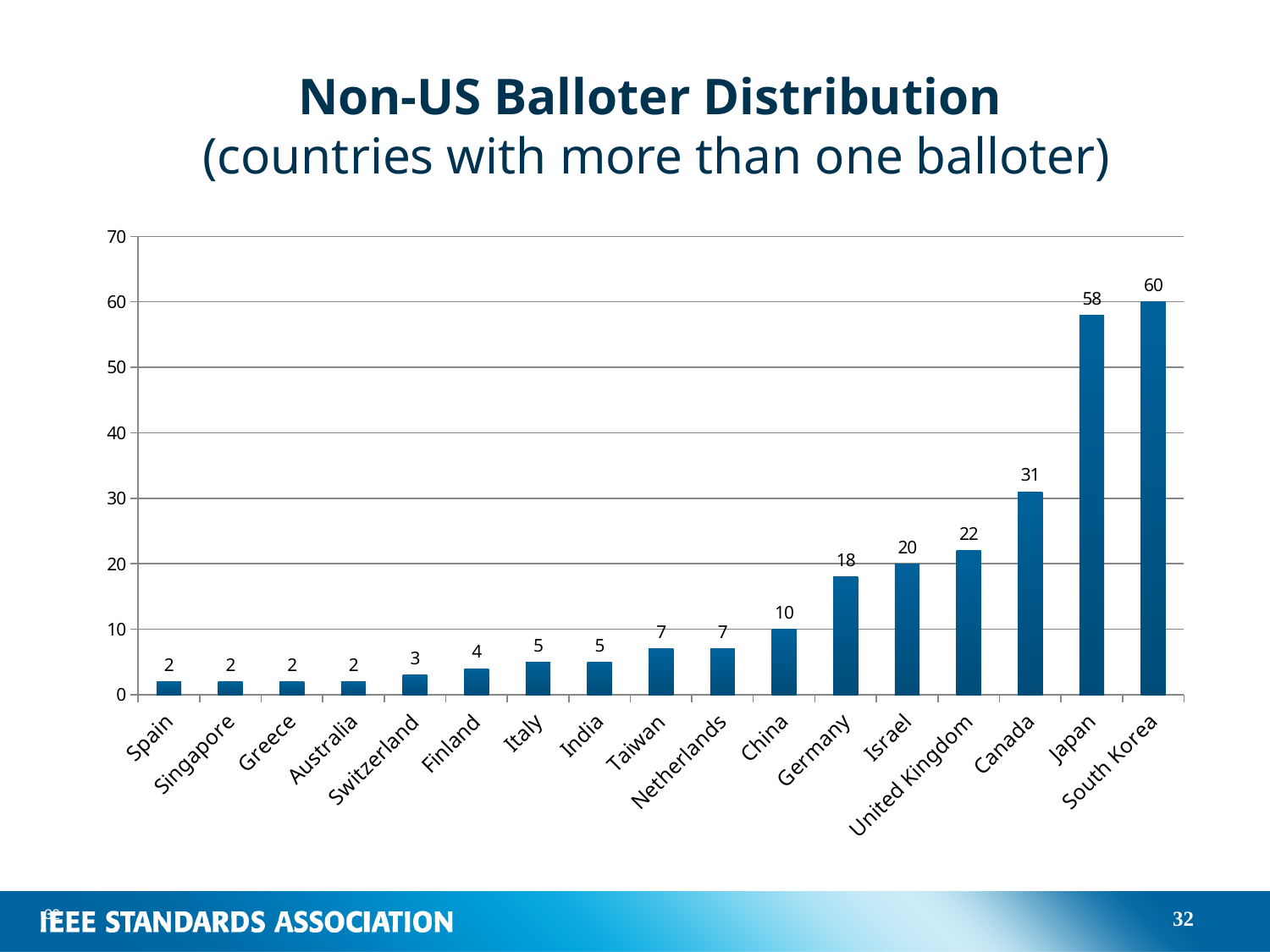
What is the value for China? 10 What is the difference between the values for United Kingdom and Israel? 2 Which is larger, the value for Germany or the value for Canada? Canada What is the difference between the values for South Korea and Japan? 2 Which country has the highest value? South Korea What is the value for Japan? 58 How many countries are shown on the chart? 17 Do the values rise or fall from left to right along the x axis? Rise Is the value for Canada greater or less than 30? greater What kind of chart is shown on the slide? Bar chart What is the value for Canada? 31 What is the title of the chart? Non-US Balloter Distribution (countries with more than one balloter)